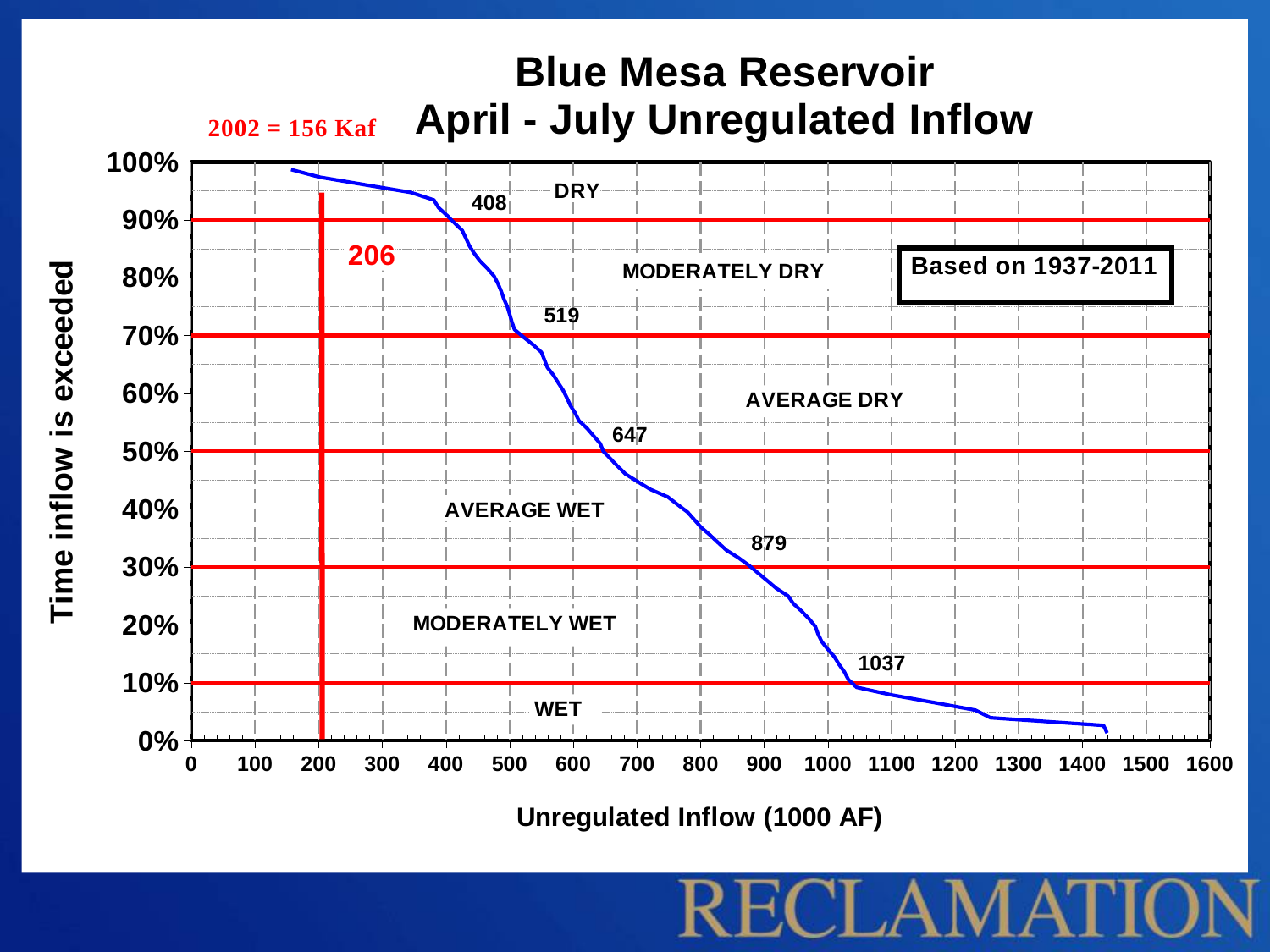
What inflow value is labeled on the curve at the 30% exceedance line? 879 What inflow value is labeled on the curve at the 50% exceedance line? 647 What inflow value is labeled on the curve at the 10% exceedance line? 1037 What kind of chart is shown on the slide? line chart What inflow value is labeled on the curve at the 90% exceedance line? 408 What inflow value is marked by the vertical red line on the chart? 206 Does the exceedance curve rise or fall as unregulated inflow increases along the x axis? fall What inflow value is labeled on the curve at the 70% exceedance line? 519 What is the difference between the labeled inflow values at the 10% and 90% exceedance lines? 629 What is the title of the chart? Blue Mesa Reservoir April - July Unregulated Inflow What is the difference between the labeled inflow values at the 30% and 50% exceedance lines? 232 What period of record is the chart based on, according to the box on the slide? 1937-2011